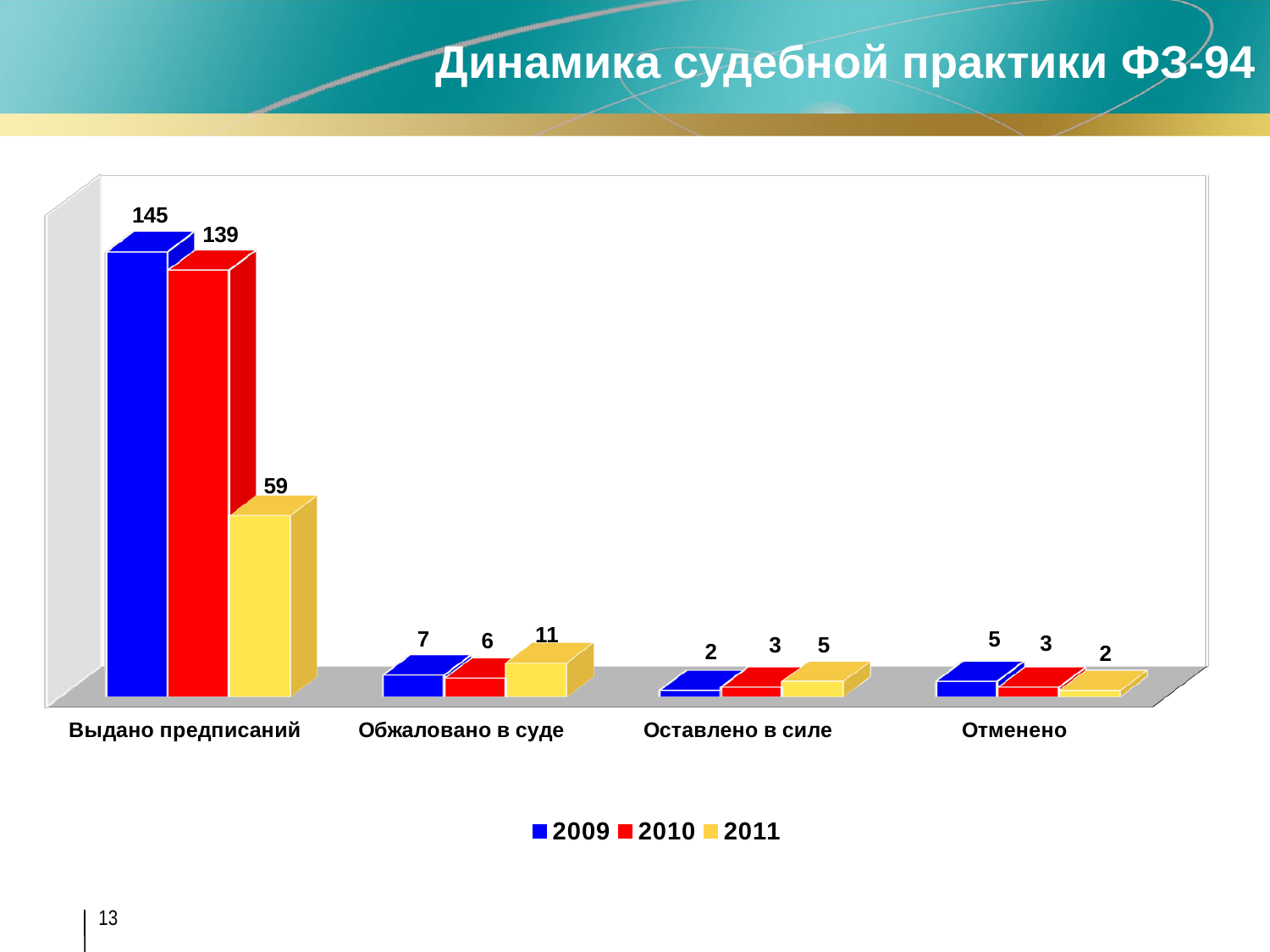
How many categories are shown on the x axis? 4 What is the value for 2009 in the category "Выдано предписаний"? 145 In the category "Обжаловано в суде", which series has the larger value, 2009 or 2011? 2011 How many series does the legend list? 3 What is the value for 2011 in the category "Обжаловано в суде"? 11 Which category has the lowest value for the 2009 series? Оставлено в силе What is the value for 2010 in the category "Оставлено в силе"? 3 Which colour represents the 2010 series in the legend? Red What kind of chart is shown on the slide? Bar chart What is the difference between the 2009 and 2011 values in the category "Выдано предписаний"? 86 Which category has the highest value for the 2011 series? Выдано предписаний What is the value for 2011 in the category "Отменено"? 2